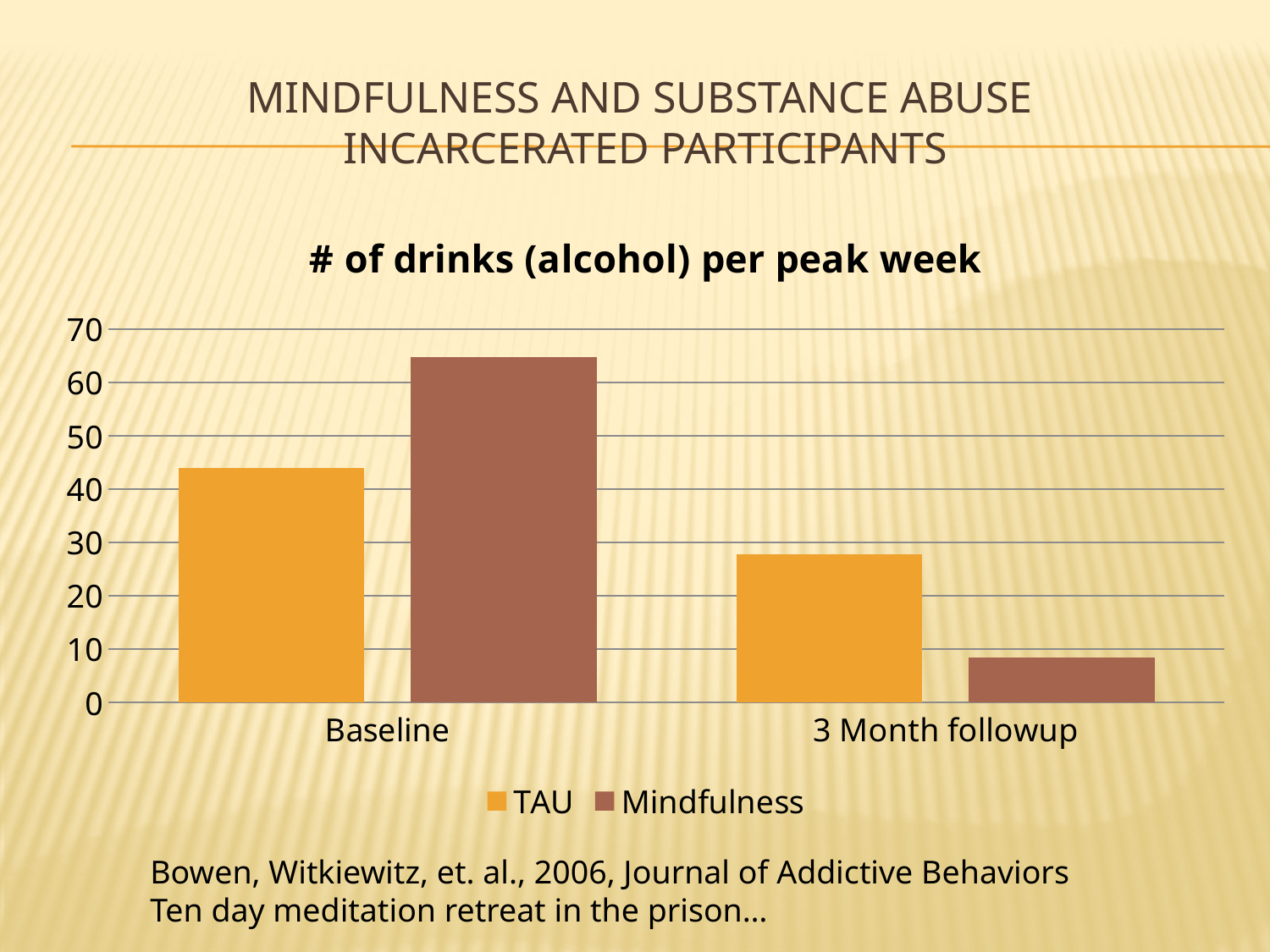
Does the Mindfulness series rise or fall from Baseline to 3 Month followup? fall Is the value for Mindfulness at Baseline greater or less than 60? greater At Baseline, which series has the larger value, TAU or Mindfulness? Mindfulness What kind of chart is shown on the slide? bar chart Which series has the highest bar in the chart? Mindfulness At 3 Month followup, which series has the larger value, TAU or Mindfulness? TAU Is the value for TAU at Baseline greater or less than 40? greater What is the title of the chart? # of drinks (alcohol) per peak week Which bar is the lowest in the chart? Mindfulness at 3 Month followup How many categories are shown on the x axis? 2 Is the value for Mindfulness at 3 Month followup greater or less than 10? less How many series does the legend list? 2